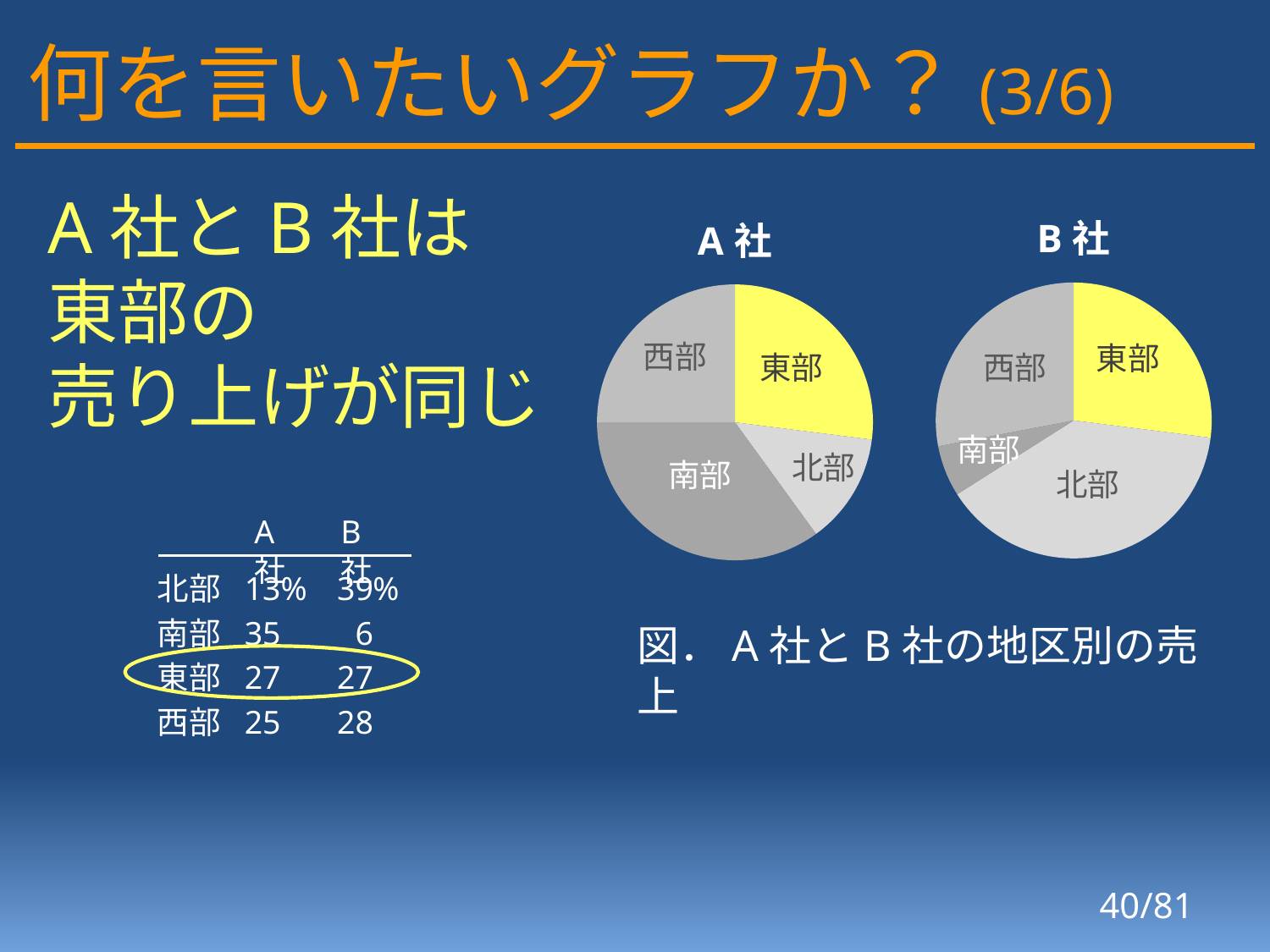
Is the 東部 slice larger in the A社 pie chart or the B社 pie chart? They are the same (27) What colour is the 東部 slice in both pie charts? Yellow In the B社 pie chart, which region has the smallest slice? 南部 According to the table on the slide, what is the value for 北部 for B社? 39% How many slices does the A社 pie chart have? 4 In the B社 pie chart, which region has the largest slice? 北部 In the A社 pie chart, which region has the smallest slice? 北部 In the A社 pie chart, which region has the largest slice? 南部 According to the table on the slide, what is the value for 南部 for B社? 6 What kind of charts are shown on the slide? Pie charts Using the table on the slide, what is the difference between B社's and A社's 北部 values? 26 According to the table on the slide, what share of A社's sales comes from 東部? 27